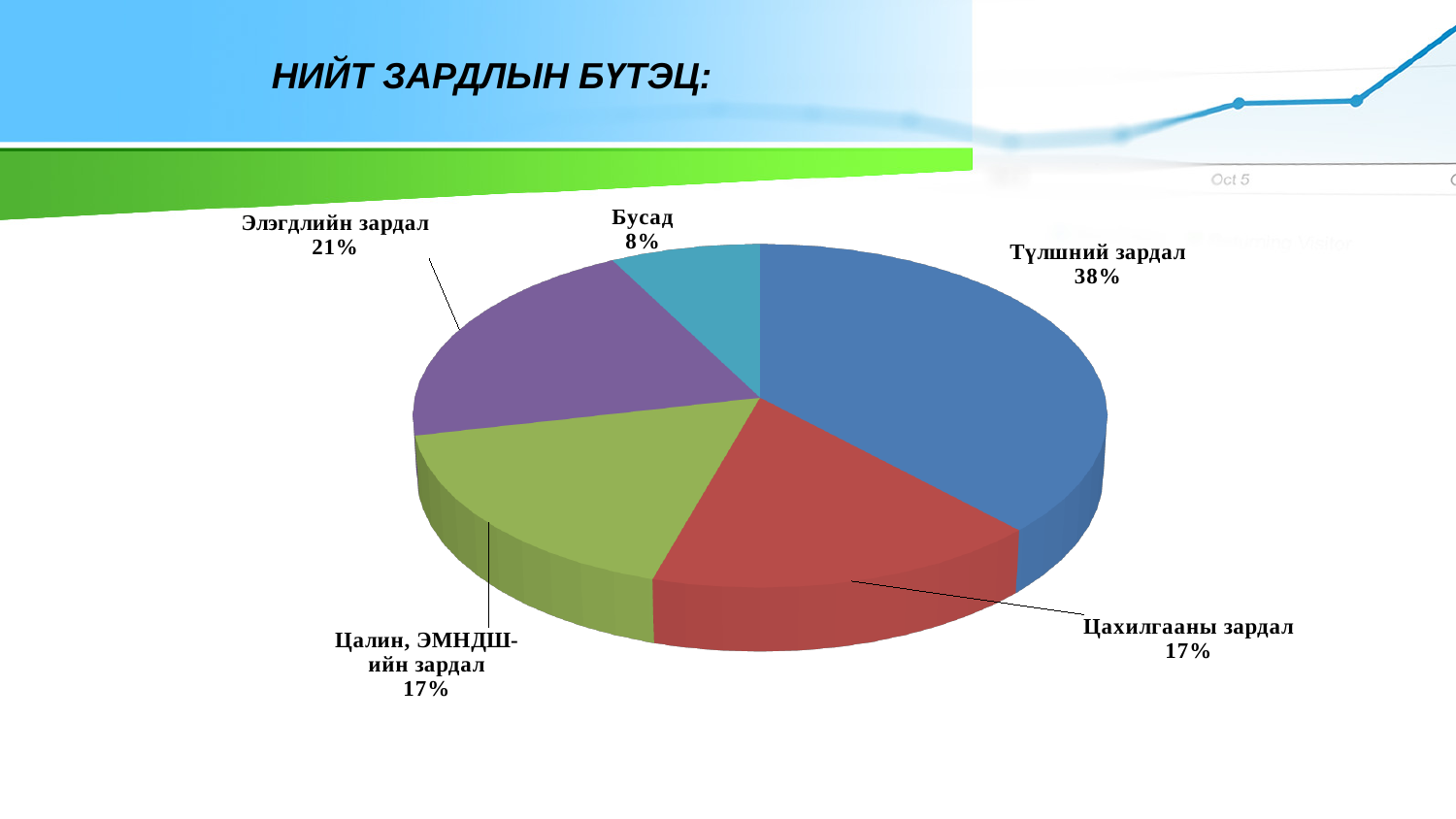
What kind of chart is shown on the slide? Pie chart Which is larger, the share for Элэгдлийн зардал or the share for Бусад? Элэгдлийн зардал What is the share for Цахилгааны зардал? 17% Which category has the largest share of the pie? Түлшний зардал What is the share for Түлшний зардал? 38% What is the share for Бусад? 8% What is the share for Элэгдлийн зардал? 21% How many slices does the pie chart have? 5 What is the title of the chart? НИЙТ ЗАРДЛЫН БҮТЭЦ: What is the difference in percentage points between Түлшний зардал and Элэгдлийн зардал? 17 What is the share for Цалин, ЭМНДШ-ийн зардал? 17% Which category has the smallest share of the pie? Бусад